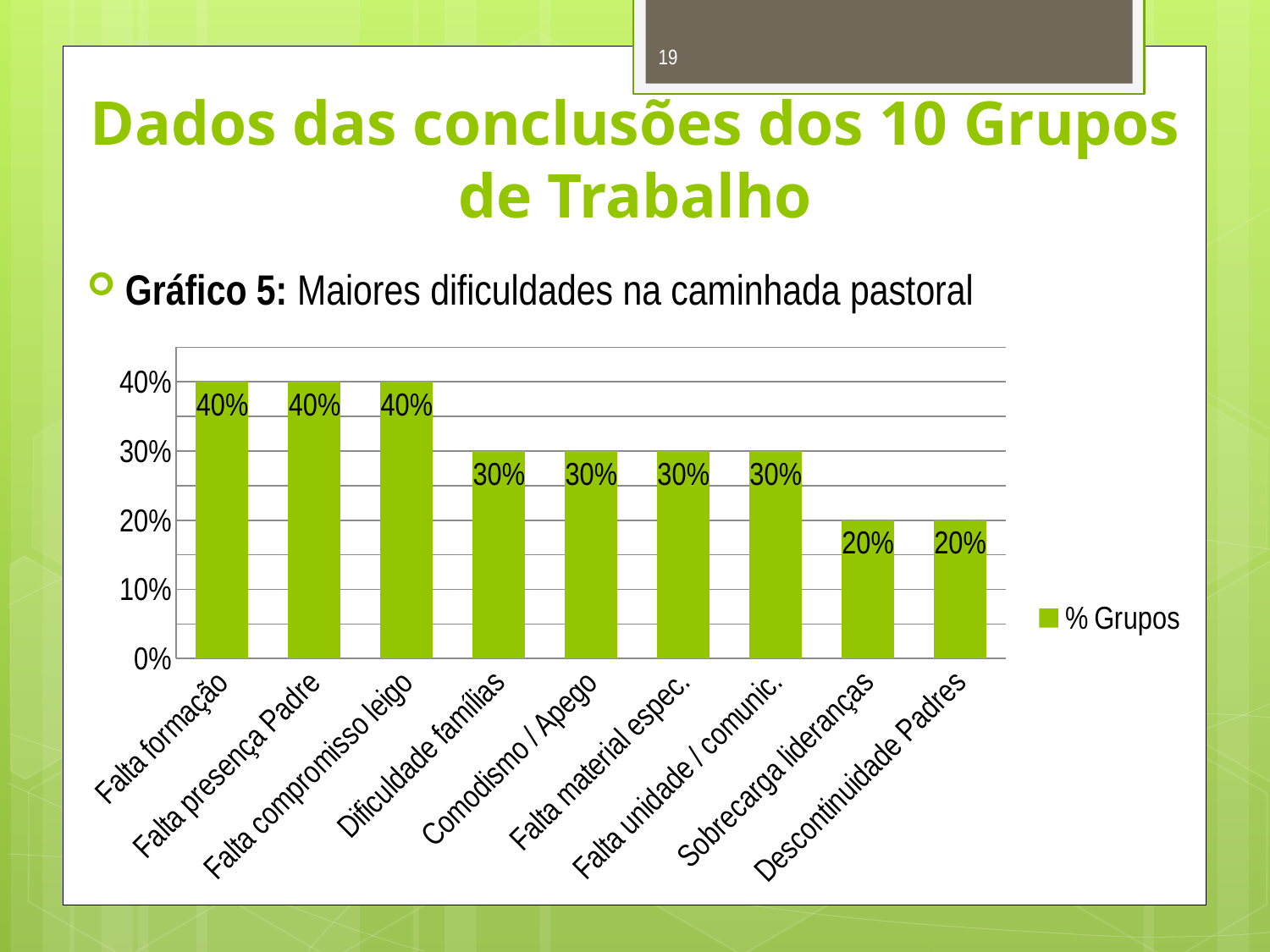
How many series does the legend list? 1 Do the values rise or fall from left to right along the x axis? fall Which is larger, the value for Falta material espec. or the value for Sobrecarga lideranças? Falta material espec. How many categories are shown on the x axis? 9 What is the difference between the values for Falta compromisso leigo and Descontinuidade Padres? 20% What is the value for Sobrecarga lideranças? 20% What is the difference between the values for Falta presença Padre and Comodismo / Apego? 10% What is the value for Falta formação? 40% What is the value for Descontinuidade Padres? 20% What kind of chart is shown? bar chart What is the value for Dificuldade famílias? 30% What is the name of the series in the legend? % Grupos